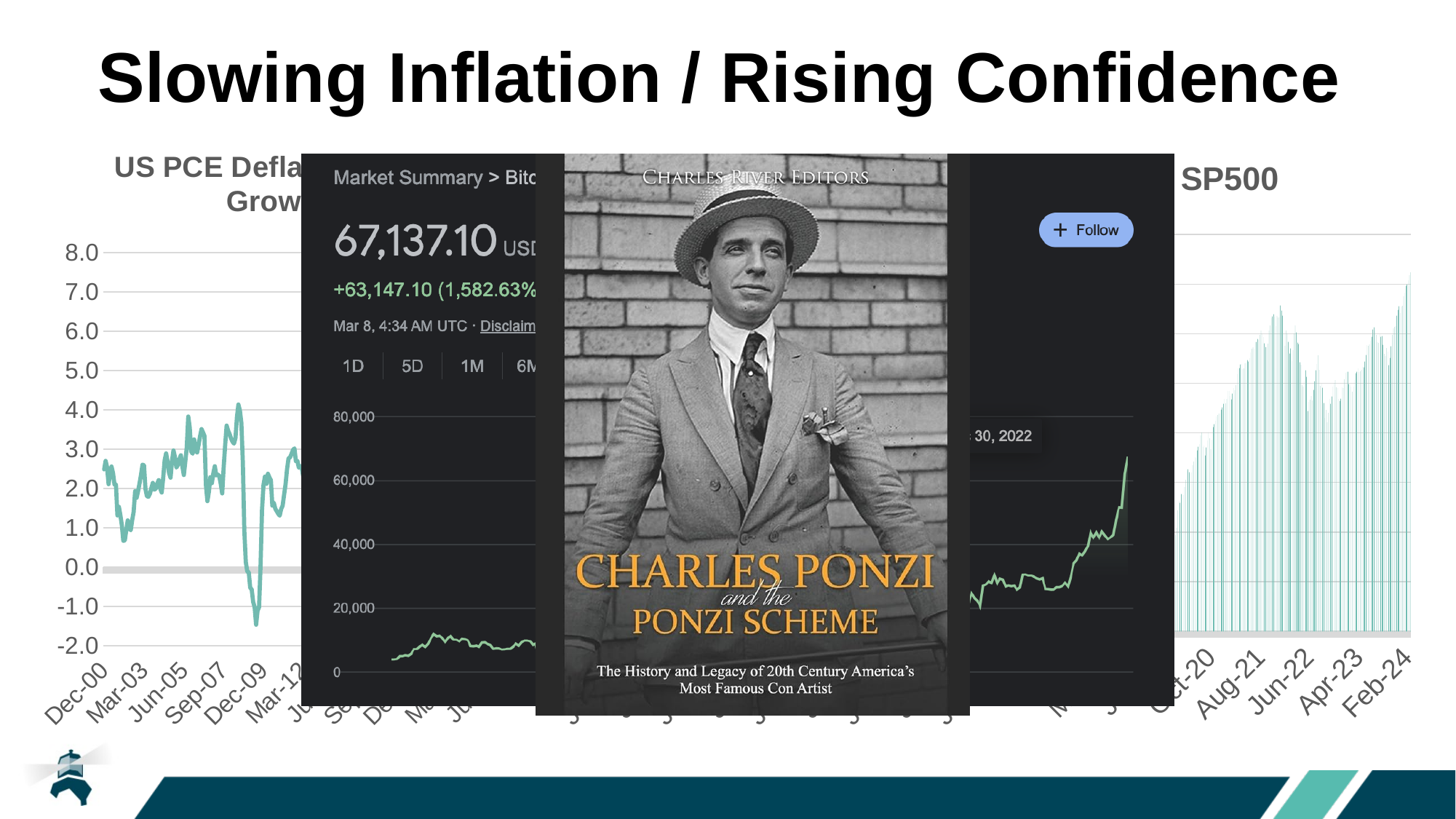
What is the title of the chart on the right of the slide? SP500 What is the highest value shown on the y axis of the chart on the left? 8.0 What percentage change is printed on the Bitcoin market summary chart? 1,582.63% On the chart on the left, is the lowest point of the line (near Dec-09) greater or less than -1.0? less What is the last x-axis label on the SP500 chart? Feb-24 What is the highest y-axis tick shown on the Bitcoin market summary chart? 80,000 What is the first x-axis label on the chart on the left? Dec-00 On the SP500 chart, do the values generally rise or fall from Oct-20 to Feb-24? rise What price is printed at the top of the Bitcoin market summary chart in the middle of the slide? 67,137.10 USD What kind of chart is the chart on the left of the slide? line chart